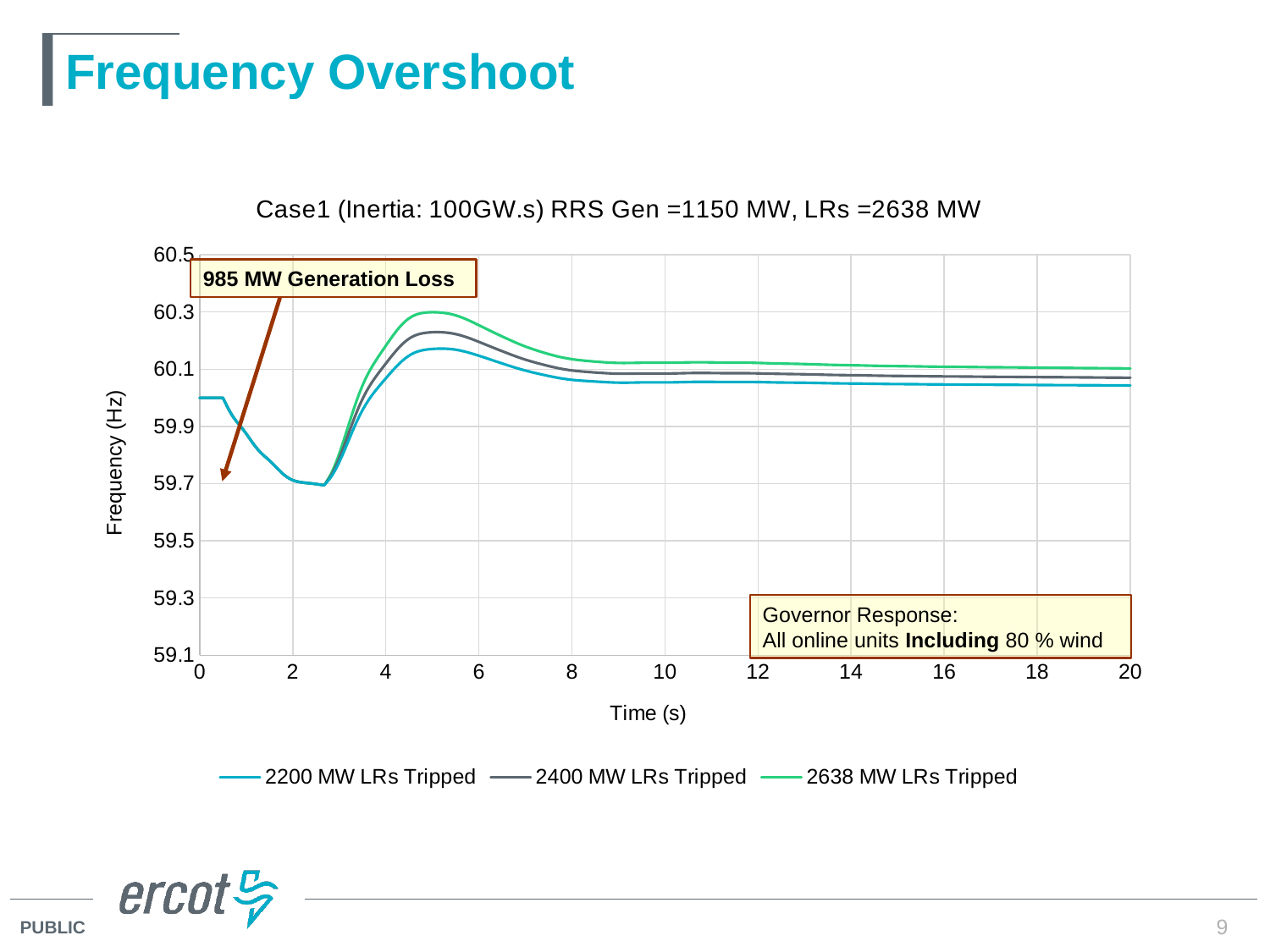
Is the value of the 2200 MW LRs Tripped series at 20 s greater or less than 59.9? greater Is the peak value of the 2638 MW LRs Tripped series greater or less than 60.1? greater How many series does the legend list? 3 What kind of chart is shown on the slide? line chart Is the lowest frequency reached by the curves greater or less than 59.9? less Between 3 s and 5 s, does the frequency rise or fall? rise Which series reaches the highest peak frequency? 2638 MW LRs Tripped At 5 s, which series has the larger value: 2200 MW LRs Tripped or 2638 MW LRs Tripped? 2638 MW LRs Tripped What is the label of the y axis? Frequency (Hz) Between 0 s and 2 s, does the frequency rise or fall? fall Which series reaches the lowest peak frequency? 2200 MW LRs Tripped What is the title of the chart? Case1 (Inertia: 100GW.s) RRS Gen =1150 MW, LRs =2638 MW